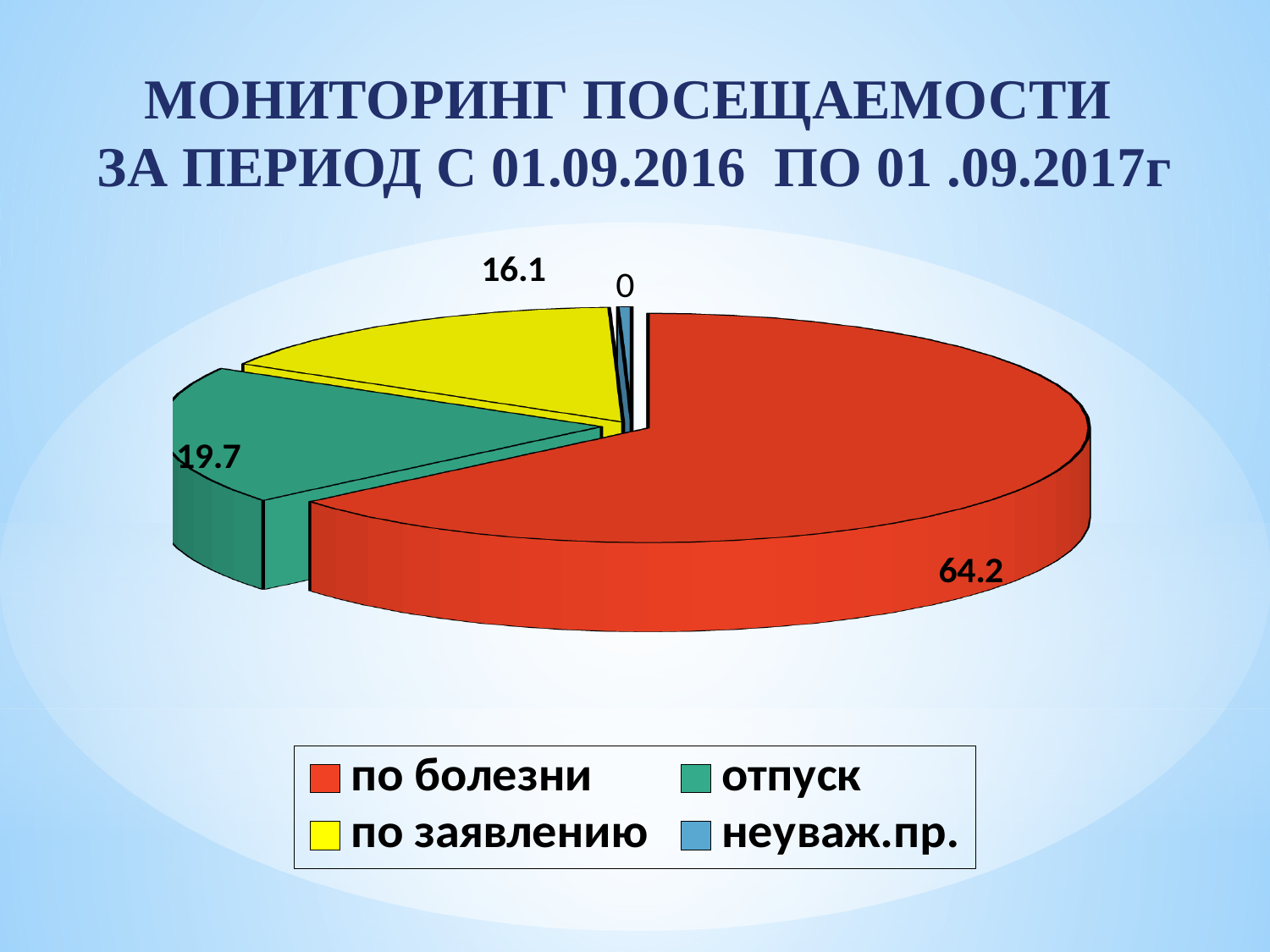
What is the difference between the values for "отпуск" and "по заявлению"? 3.6 Which category has the largest slice of the pie? по болезни Which category has the smallest slice of the pie? неуваж.пр. What value is shown for the "по болезни" slice? 64.2 What value is shown for the "неуваж.пр." slice? 0 What is the difference between the values for "по болезни" and "отпуск"? 44.5 What value is shown for the "отпуск" slice? 19.7 What colour is the "по заявлению" slice? yellow Which is larger, the value for "отпуск" or the value for "по заявлению"? отпуск What kind of chart is shown on the slide? pie chart What value is shown for the "по заявлению" slice? 16.1 How many categories does the legend list? 4